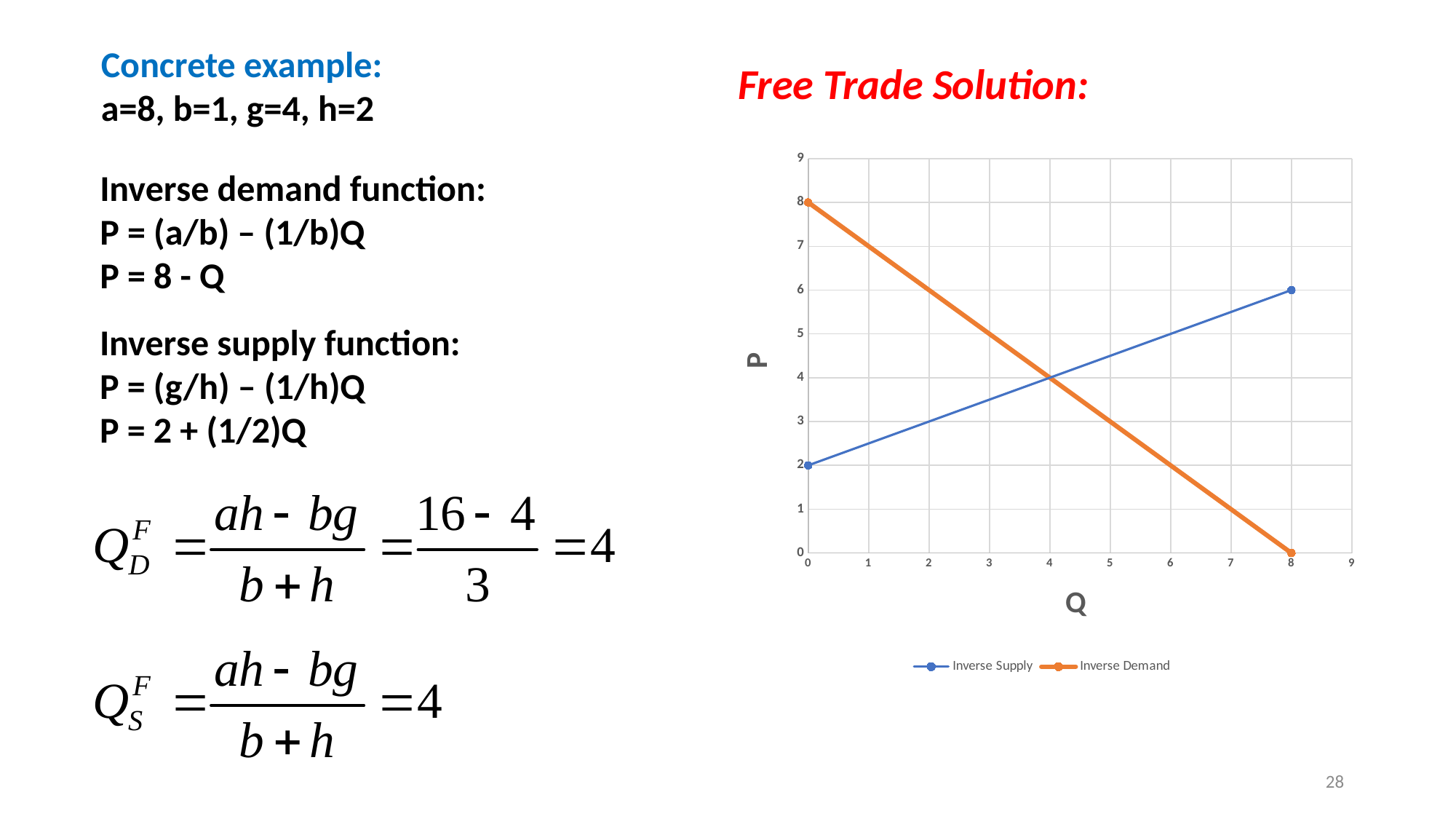
What are the names of the two series in the chart legend? Inverse Supply and Inverse Demand What is the value of P for the Inverse Demand line at Q = 8? 0 How many series does the chart legend list? 2 What is the value of P for the Inverse Demand line at Q = 0? 8 What type of chart is shown on the slide? line chart What is the label of the vertical axis of the chart? P What is the difference in P between the Inverse Demand line and the Inverse Supply line at Q = 0? 6 What is the value of P for the Inverse Supply line at Q = 0? 2 What is the value of P for the Inverse Supply line at Q = 8? 6 Does the Inverse Supply line rise or fall as Q increases? rise At Q = 0, which series has the higher value of P, Inverse Supply or Inverse Demand? Inverse Demand Does the Inverse Demand line rise or fall as Q increases? fall